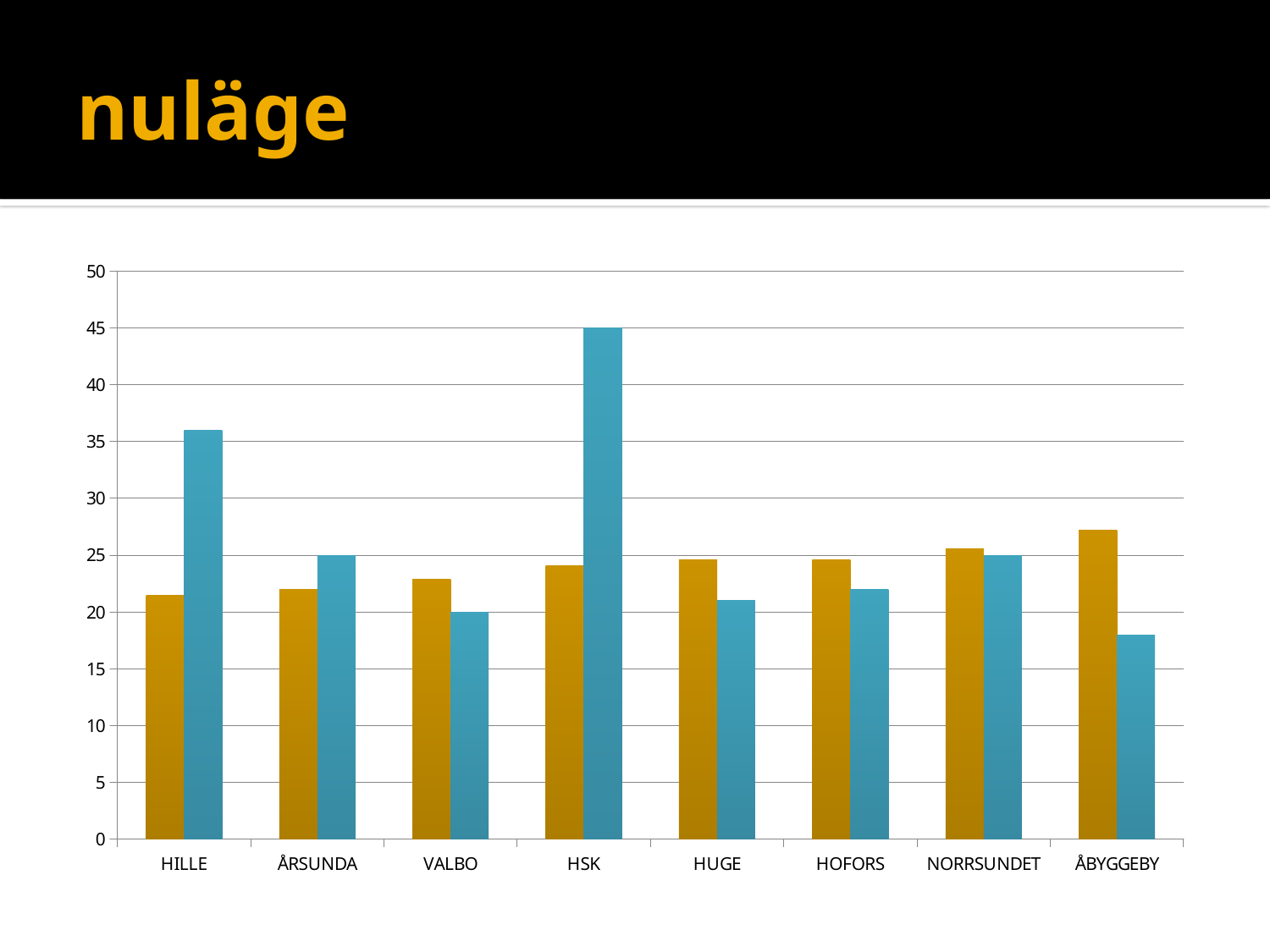
Which category has the lowest blue bar? ÅBYGGEBY How many categories are shown on the x axis of the chart? 8 For HILLE, which bar is taller, the orange one or the blue one? blue For ÅBYGGEBY, which bar is taller, the orange one or the blue one? orange Which category has the highest orange bar? ÅBYGGEBY What kind of chart is shown on the slide? bar chart What is the value of the blue bar for VALBO? 20 Which category has the highest blue bar? HSK What is the value of the blue bar for HSK? 45 Is the blue bar for ÅBYGGEBY greater or less than 20? less What is the title of the slide containing the chart? nuläge Is the blue bar for HILLE greater or less than 30? greater